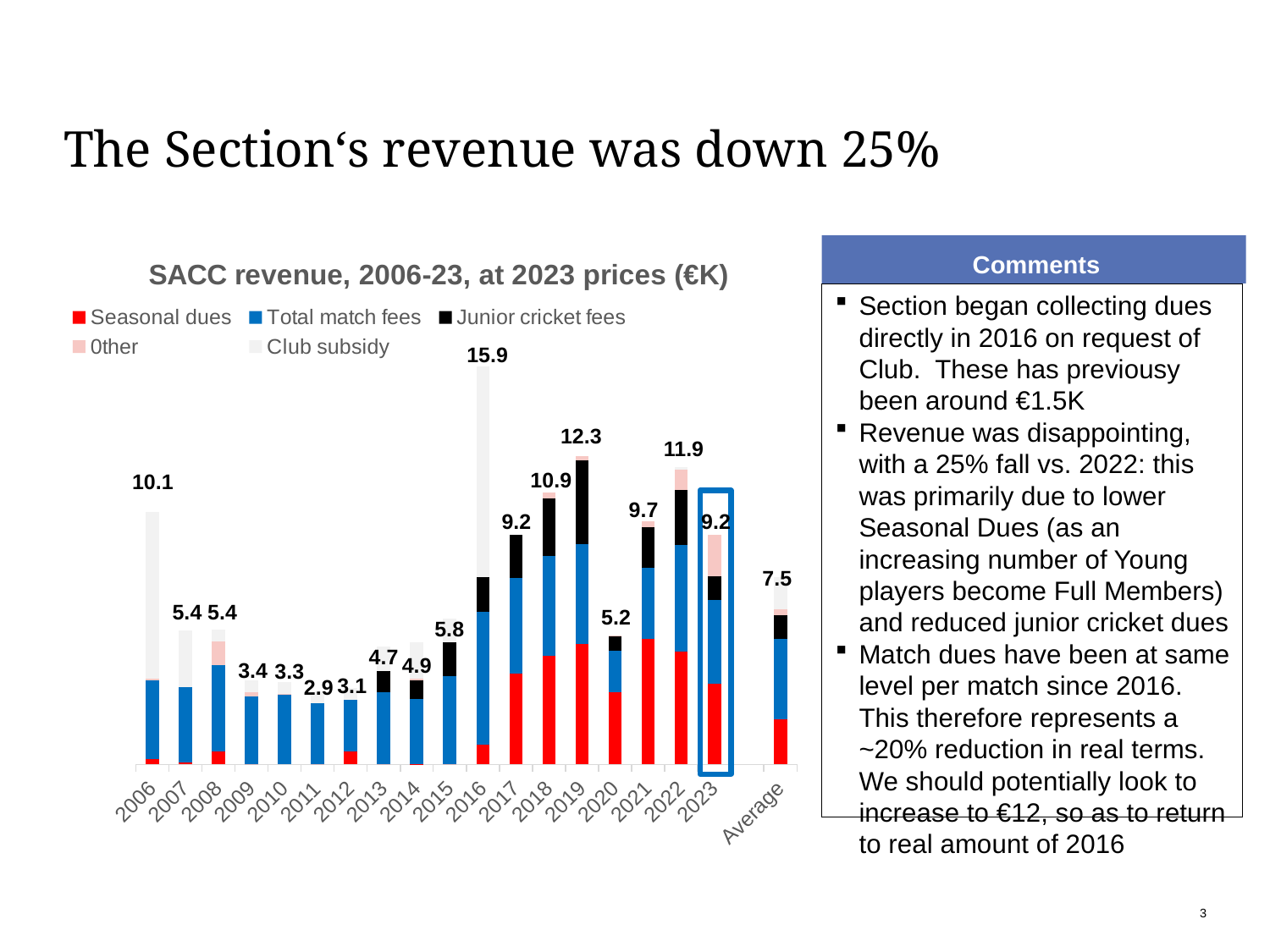
What is the difference between the total revenue for 2022 and 2023? 2.7 Which year has the larger total revenue, 2019 or 2018? 2019 What kind of chart is shown on the slide? Stacked bar chart What is the title of the chart? SACC revenue, 2006-23, at 2023 prices (€K) What is the value shown for the Average bar? 7.5 Which year has the lowest total revenue in the chart? 2011 What is the total SACC revenue shown for 2023? 9.2 Did total revenue rise or fall from 2006 to 2011? Fall What is the total SACC revenue shown for 2016? 15.9 How many bars are plotted in the chart, including the Average bar? 19 How many series does the legend list? 5 Which year has the highest total revenue in the chart? 2016